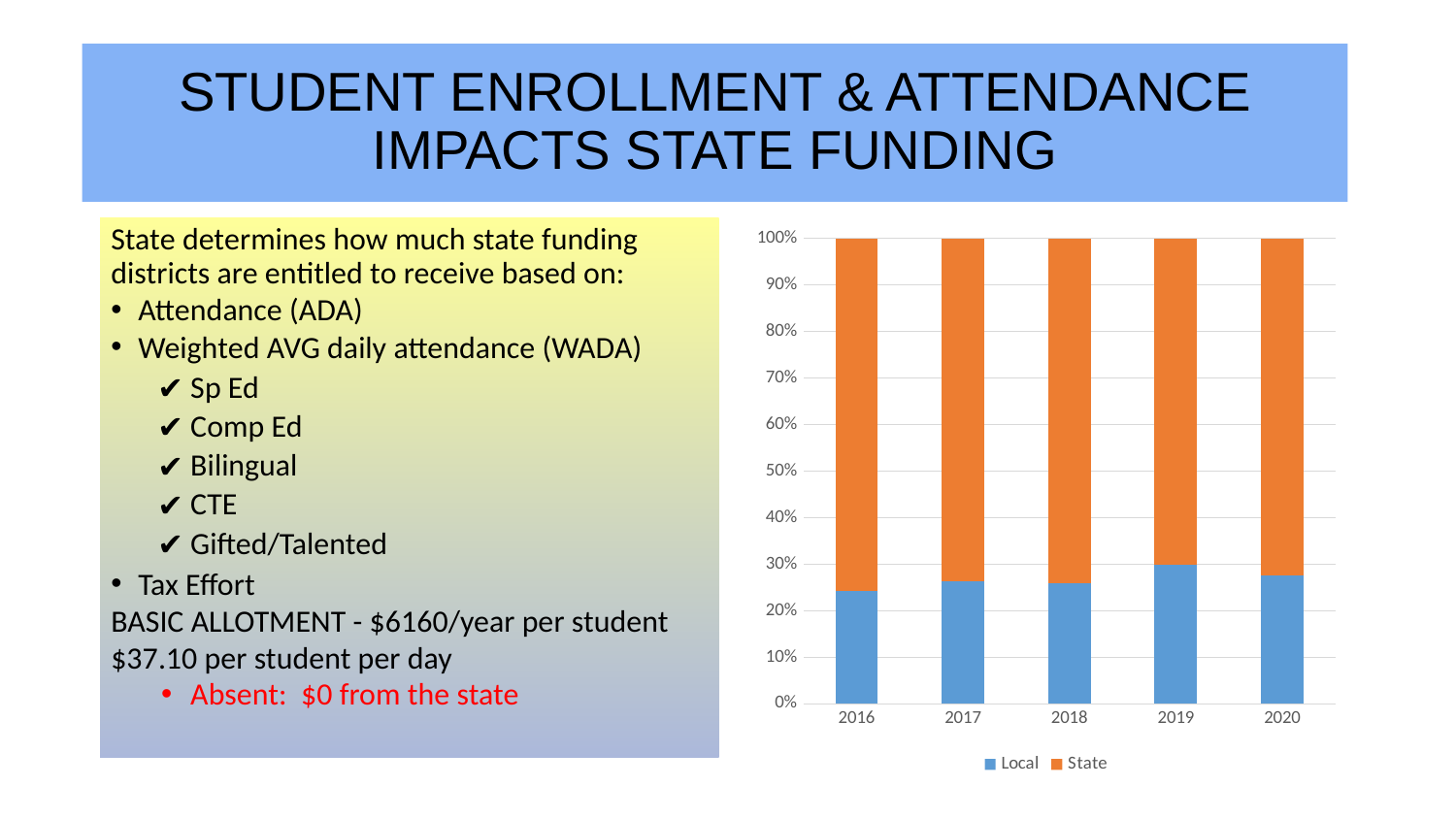
In which year is the Local share the highest? 2019 Which year has the larger Local share, 2016 or 2019? 2019 Which year has the larger State share, 2016 or 2019? 2016 How many series does the chart legend list? 2 What is the total of the stacked bar for 2018? 100% Is the State share for 2016 greater or less than 70%? greater What are the two series listed in the chart legend? Local and State How many years are shown on the x axis of the chart? 5 Is the Local value for 2019 greater or less than 20%? greater What kind of chart is shown on the slide? bar chart Which colour represents the State series in the chart? orange Is the Local value for 2016 greater or less than 30%? less